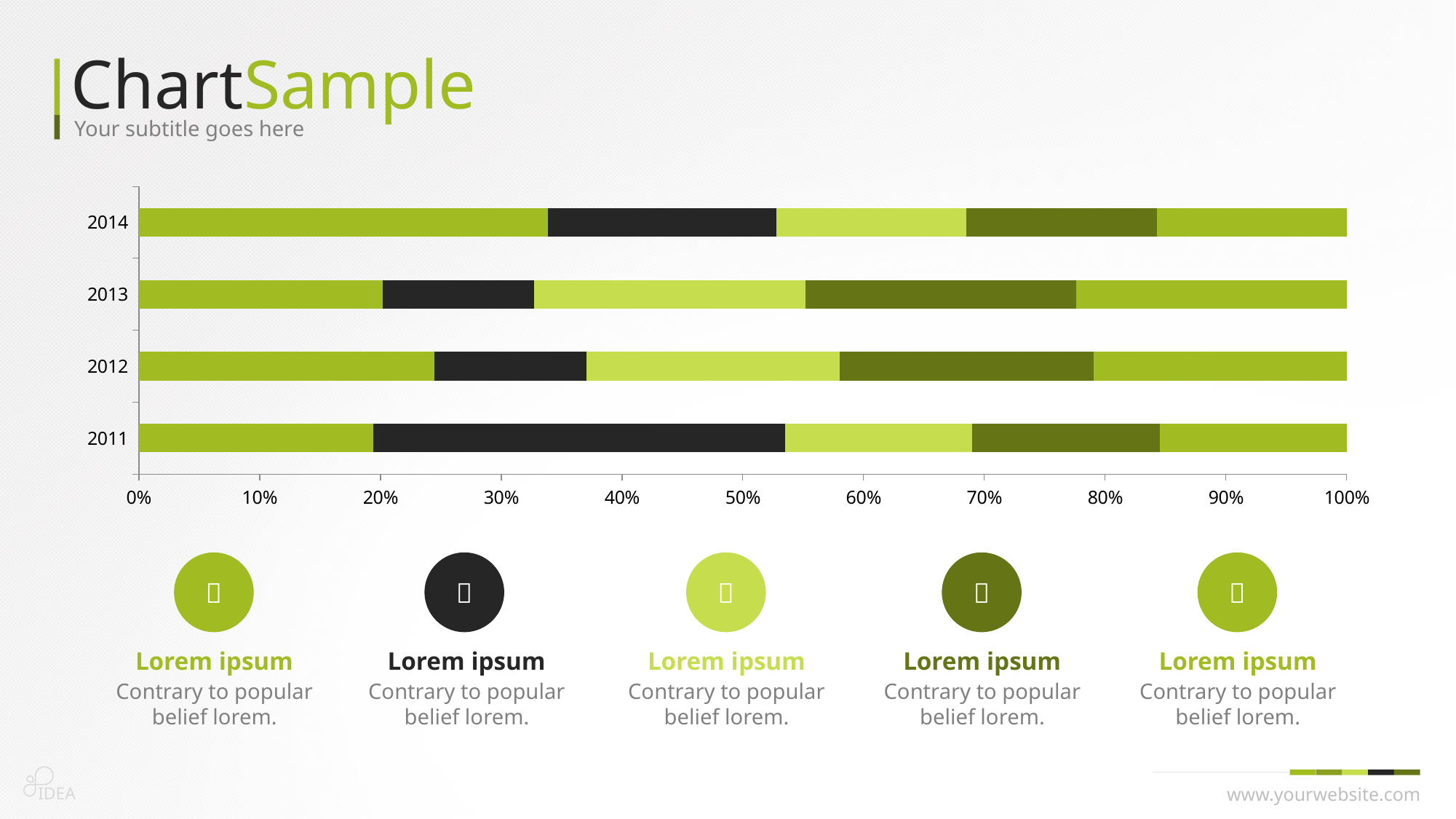
What kind of chart is shown on the slide? Stacked bar chart How many years (categories) are plotted on the chart? 4 Is the dark (black) segment for 2013 greater or less than 20%? less Is the leftmost (light green) segment for 2012 greater or less than 20%? greater What is the highest value shown on the horizontal axis? 100% Is the dark (black) segment for 2011 greater or less than 30%? greater Which year has the largest leftmost (light green) segment? 2014 Which years are shown on the vertical axis of the chart? 2011, 2012, 2013, 2014 Which year has the largest dark (black) segment? 2011 How many series (colour segments) does each bar contain? 5 Is the dark (black) segment larger for 2011 or for 2012? 2011